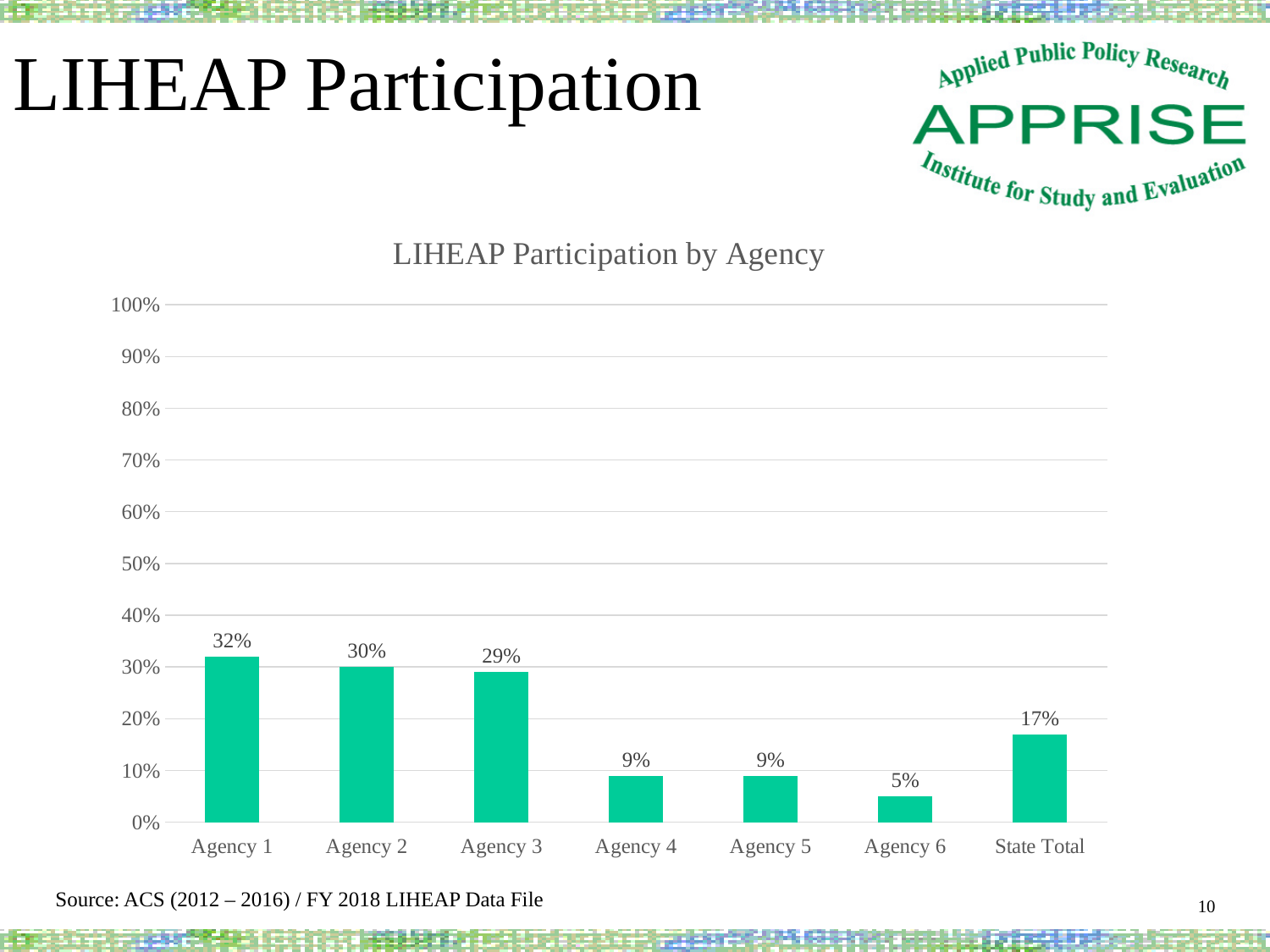
Is the value for Agency 2 greater or less than 20%? greater How many categories are shown on the x axis of the chart? 7 What is the State Total LIHEAP participation rate? 17% What is the title of the chart? LIHEAP Participation by Agency Which has a higher participation rate, Agency 3 or Agency 4? Agency 3 What is the difference between the participation rates of Agency 1 and Agency 6? 27% Which agency has the highest LIHEAP participation rate? Agency 1 Which agency has the lowest LIHEAP participation rate? Agency 6 What is the LIHEAP participation rate for Agency 1? 32% What kind of chart is shown on the slide? Bar chart What is the LIHEAP participation rate for Agency 6? 5% What is the difference between the participation rates of Agency 2 and the State Total? 13%